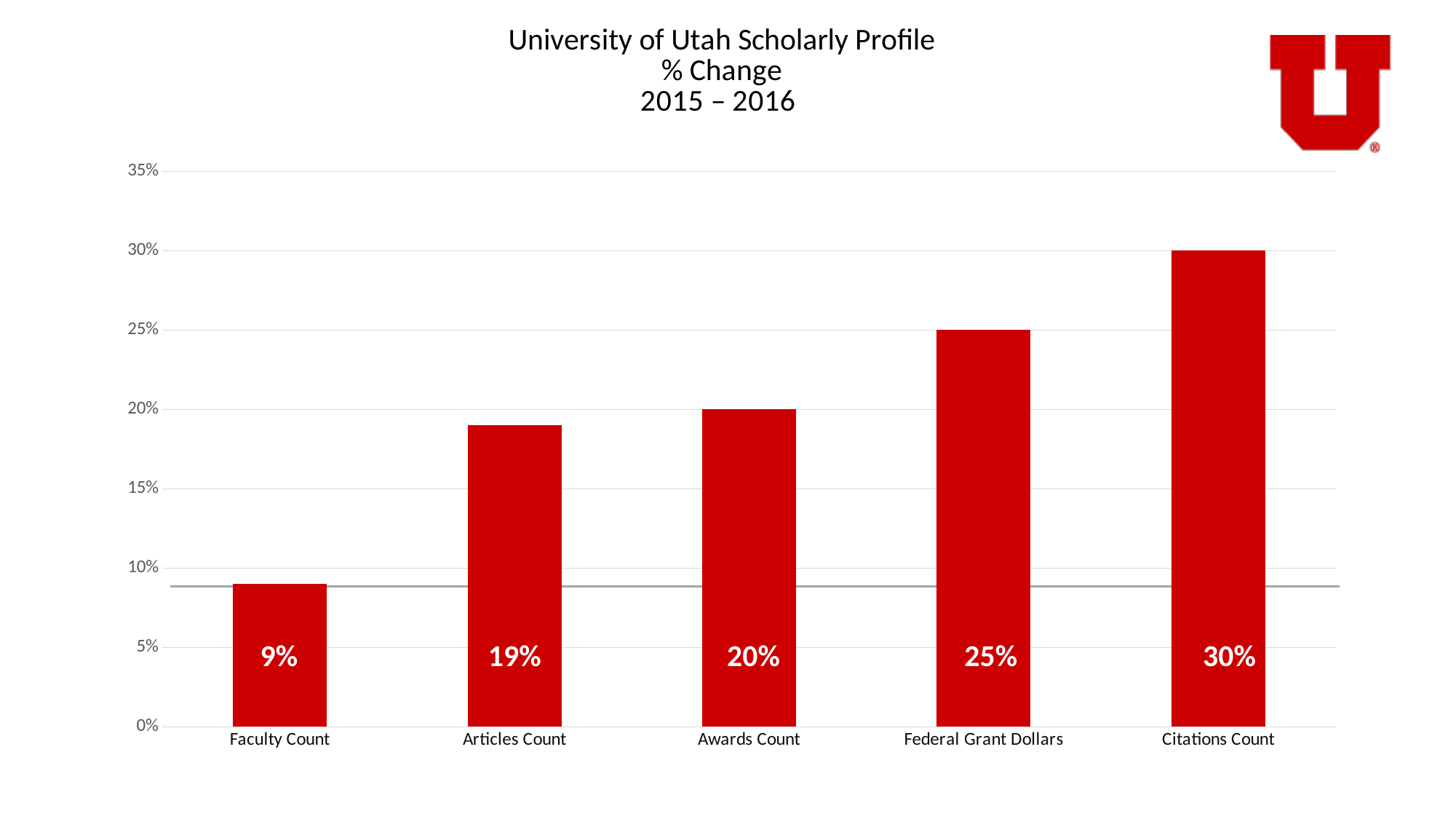
What is the difference between the % change for Federal Grant Dollars and Awards Count? 5% What is the % change for Federal Grant Dollars? 25% What is the % change for Articles Count? 19% What is the % change for Faculty Count? 9% Which is larger, the % change for Awards Count or Articles Count? Awards Count Do the values rise or fall from left to right along the x axis? Rise What is the difference between the % change for Citations Count and Faculty Count? 21% Which category has the lowest % change? Faculty Count Which category has the highest % change? Citations Count Is the value for Citations Count greater or less than 25%? greater How many categories are shown on the chart? 5 What kind of chart is shown on the slide? Bar chart